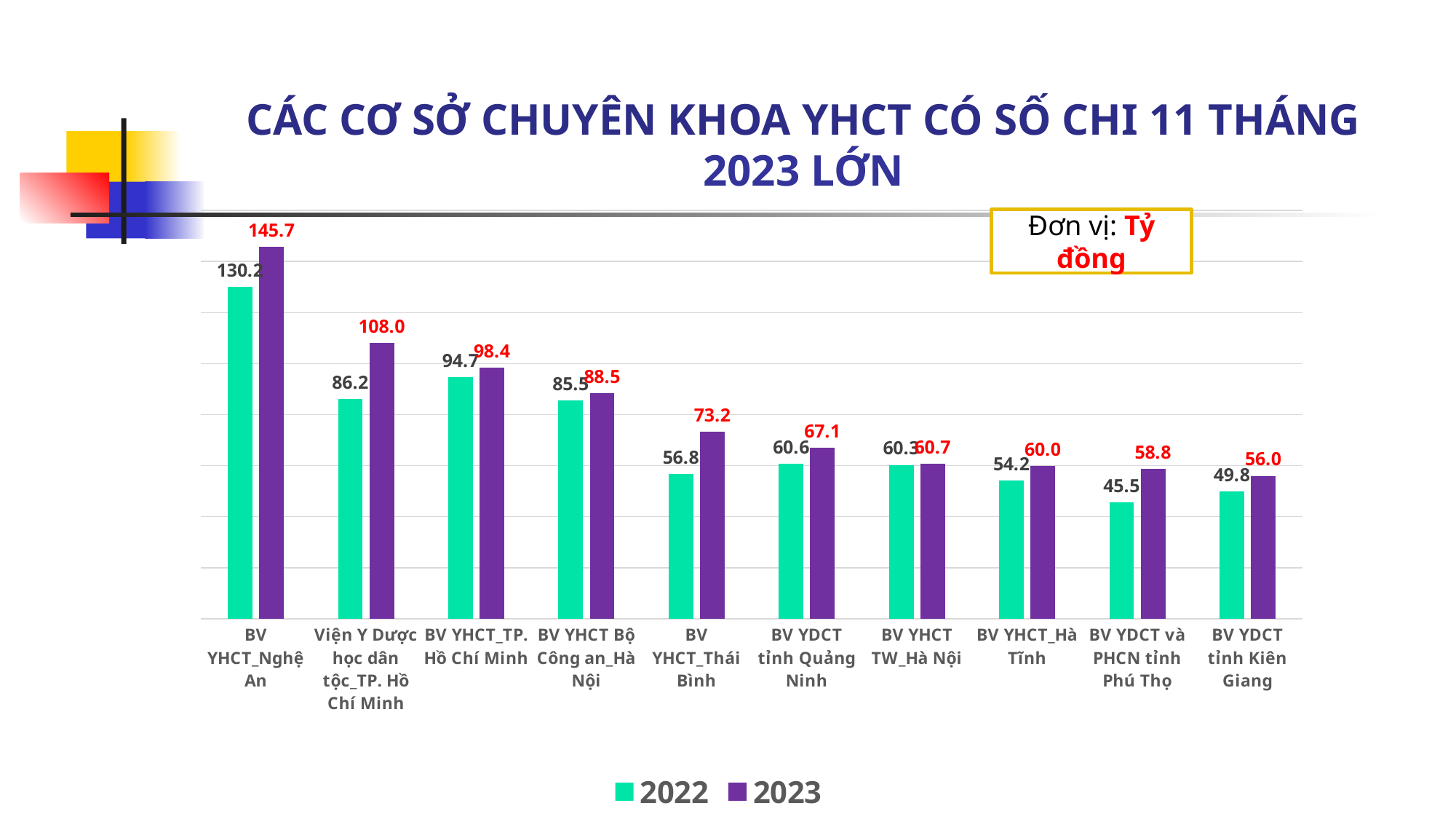
Which facility has the highest 2023 value? BV YHCT_Nghệ An Do the 2023 values rise or fall moving from left to right along the x axis? fall What is the 2022 value for Viện Y Dược học dân tộc_TP. Hồ Chí Minh? 86.2 What is the 2023 value for BV YDCT và PHCN tỉnh Phú Thọ? 58.8 What unit is stated in the box on the slide? Tỷ đồng What is the 2023 value for BV YHCT_Nghệ An? 145.7 How many series does the legend list? 2 Which facility has the lowest 2022 value? BV YDCT và PHCN tỉnh Phú Thọ What is the difference between the 2023 and 2022 values for BV YHCT_Nghệ An? 15.5 What type of chart is shown on the slide? bar chart Which is larger: the 2023 value for BV YHCT_Thái Bình or the 2023 value for BV YDCT tỉnh Quảng Ninh? BV YHCT_Thái Bình How many facilities (categories) are shown on the x axis? 10